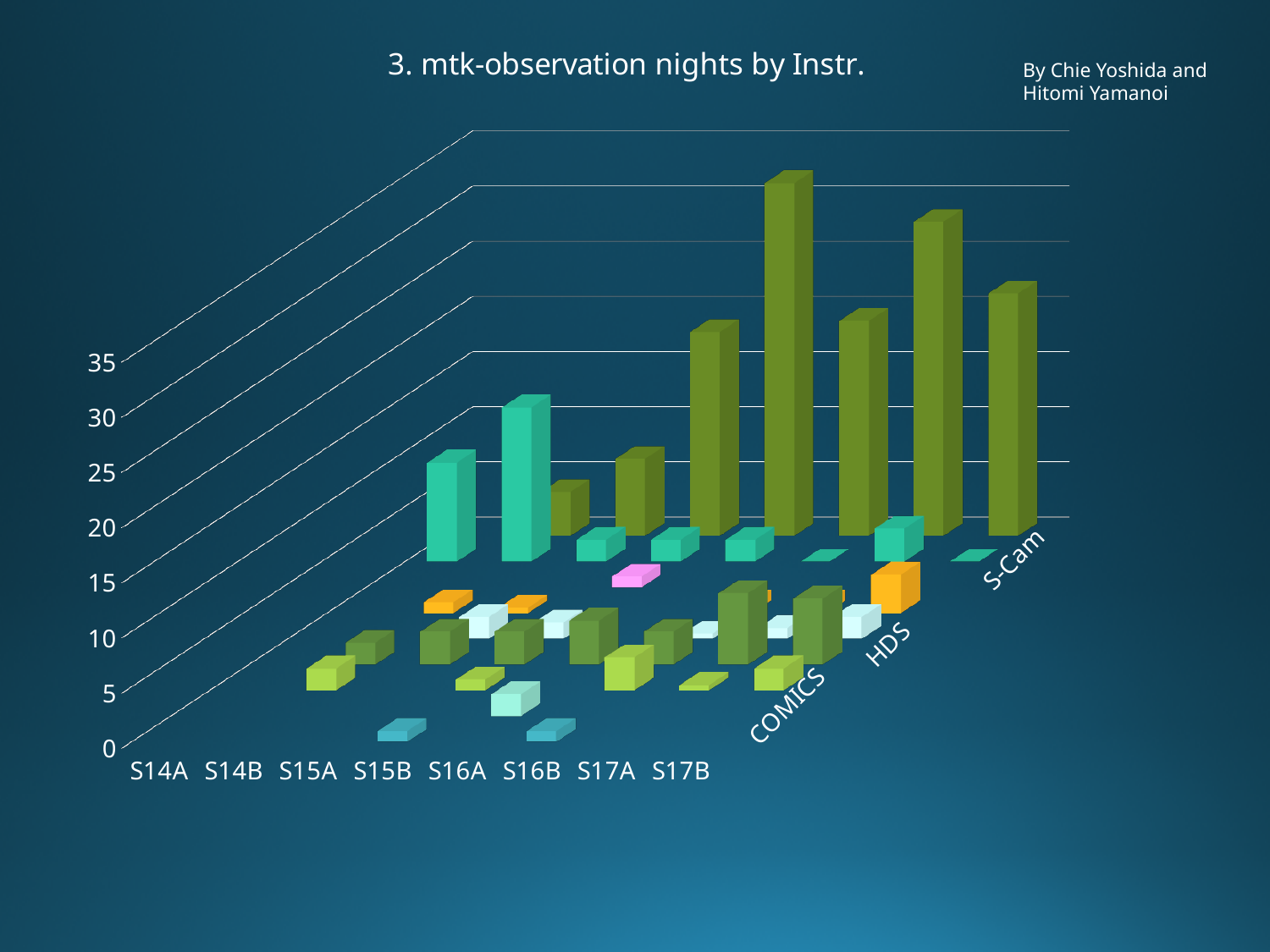
How many semester categories are labelled along the x axis? 8 What is the highest value shown on the vertical axis? 35 What is the title of the chart? 3. mtk-observation nights by Instr. Which semester label appears first on the x axis? S14A What kind of chart is shown on the slide? 3D bar chart